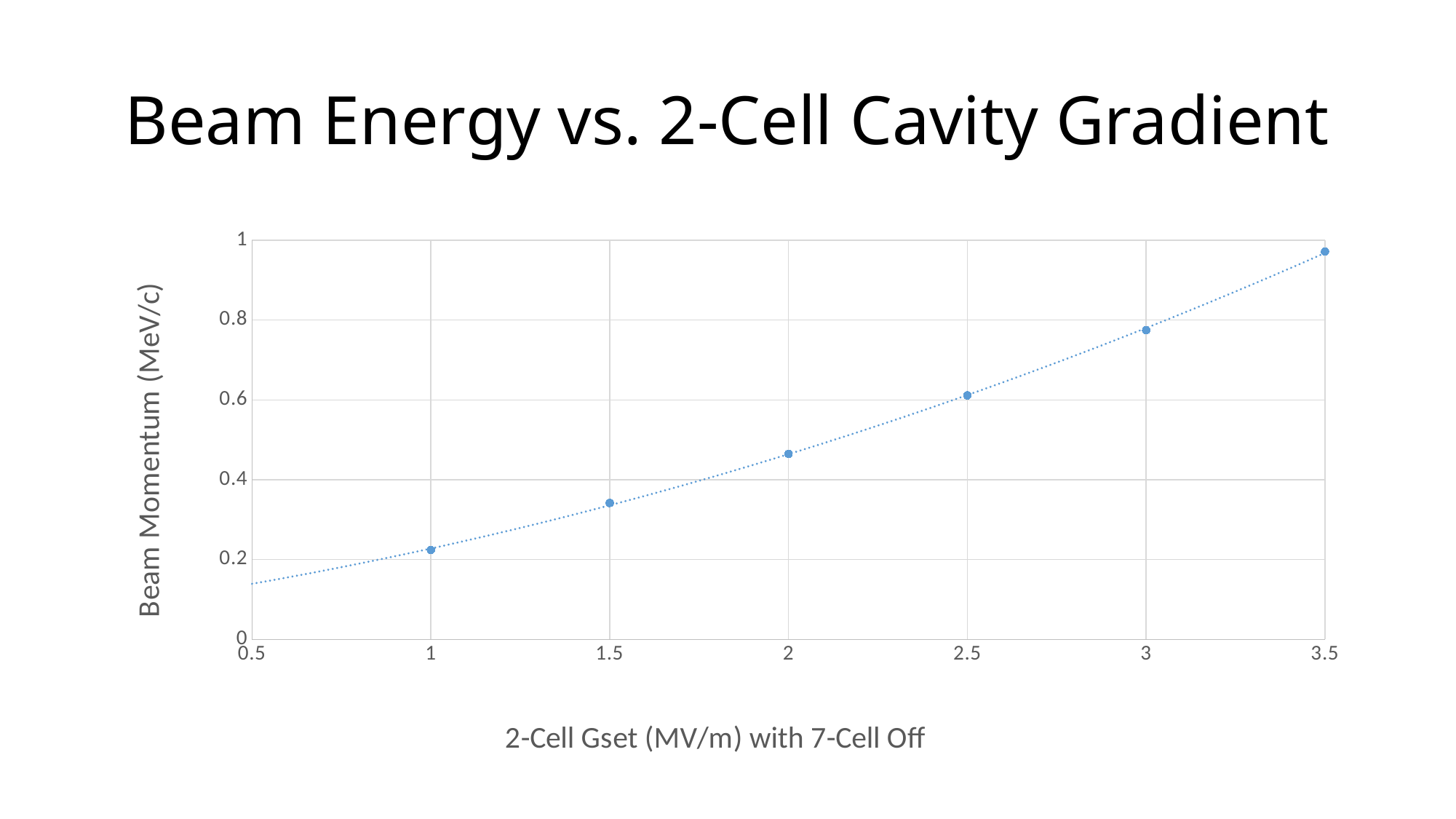
Which has the larger beam momentum: a 2-Cell Gset of 2.5 or a 2-Cell Gset of 1? 2.5 Is the beam momentum at a 2-Cell Gset of 2 greater or less than 0.4? greater Do the beam momentum values rise or fall as the 2-Cell Gset increases along the x axis? rise At which 2-Cell Gset value is the beam momentum lowest? 1 Is the beam momentum at a 2-Cell Gset of 1.5 greater or less than 0.4? less At which 2-Cell Gset value is the beam momentum highest? 3.5 How many data points are plotted on the chart? 6 What is the title of the chart? Beam Energy vs. 2-Cell Cavity Gradient Is the beam momentum at a 2-Cell Gset of 3 greater or less than 0.6? greater What is the label of the y axis? Beam Momentum (MeV/c) What kind of chart is shown on the slide? scatter chart